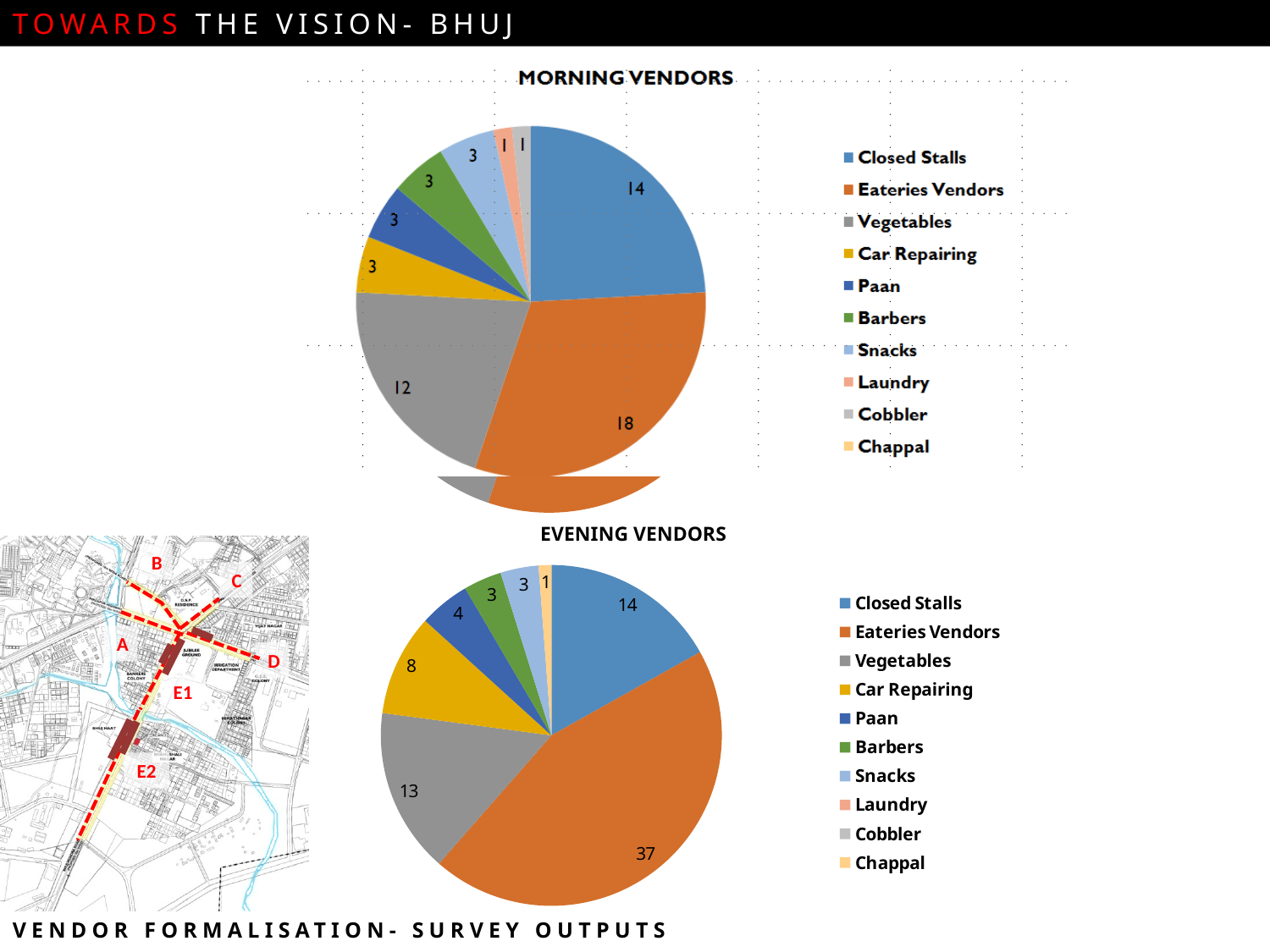
What kind of chart is the Morning Vendors chart? Pie chart In the Evening Vendors pie chart, what is the difference between Eateries Vendors and Closed Stalls? 23 How many categories does the legend of the Evening Vendors chart list? 10 In the Evening Vendors pie chart, what is the value for Eateries Vendors? 37 In the Morning Vendors pie chart, which category has the largest slice? Eateries Vendors In the Morning Vendors pie chart, what is the difference between Eateries Vendors and Vegetables? 6 In the Evening Vendors pie chart, what is the value for Vegetables? 13 In the Evening Vendors pie chart, what is the value for Car Repairing? 8 In the Morning Vendors pie chart, what is the value for Vegetables? 12 In the Morning Vendors pie chart, which is larger, Closed Stalls or Vegetables? Closed Stalls In the Morning Vendors pie chart, what is the value for Eateries Vendors? 18 In the Evening Vendors pie chart, what is the value for Paan? 4